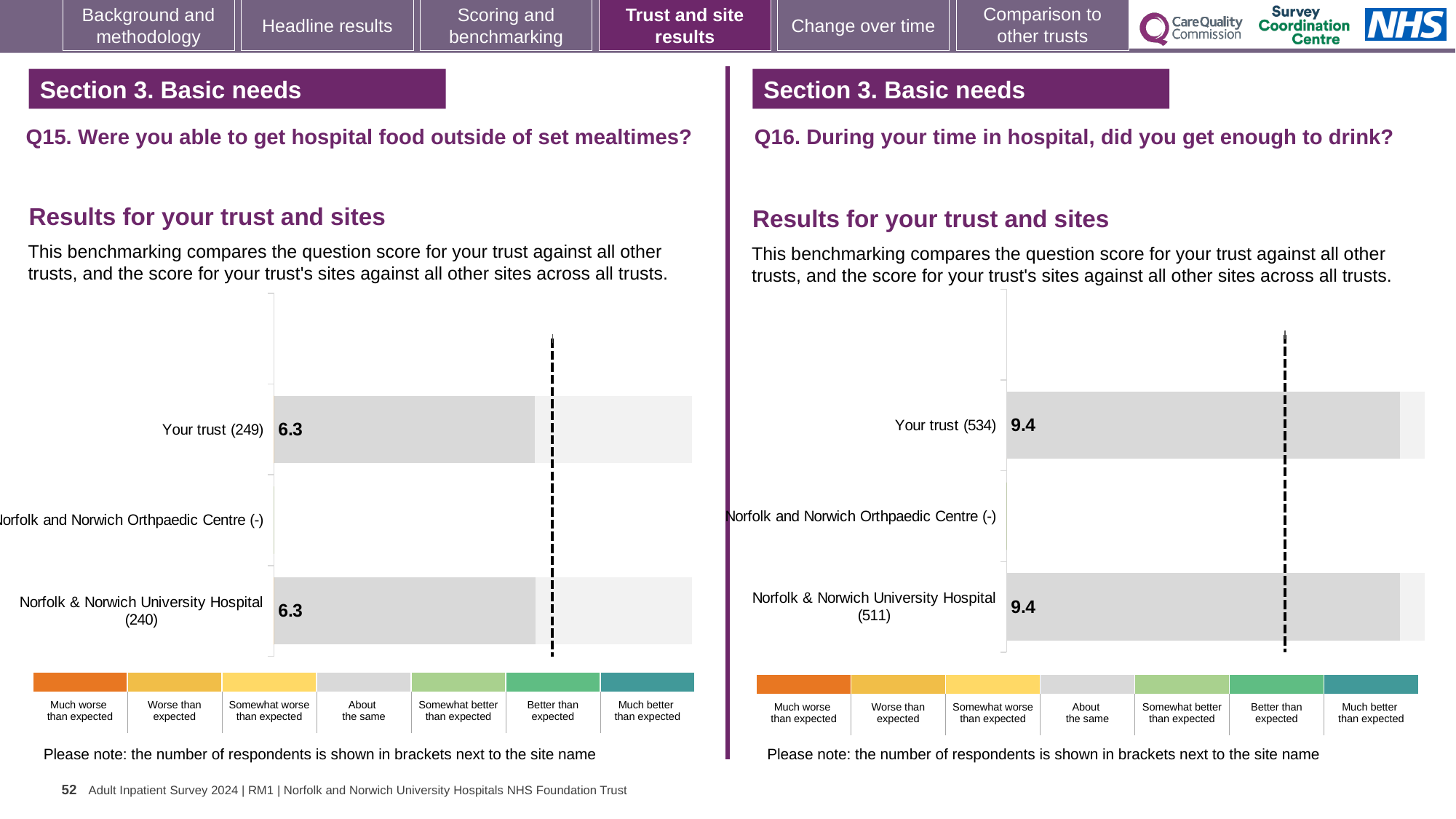
Which is larger: the Your trust score on the Q15 chart (left) or the Your trust score on the Q16 chart (right)? Q16 chart (right) On the Q15 chart (left), what is the score for Your trust? 6.3 On the Q15 chart (left), how many respondents are shown in brackets for Norfolk & Norwich University Hospital? 240 On the Q16 chart (right), what is the score for Your trust? 9.4 What kind of chart is the Q16 chart (right)? Bar chart How many categories are listed on the Q16 chart (right)? 3 How many categories are listed on the Q15 chart (left)? 3 On the Q16 chart (right), how many respondents are shown in brackets for Your trust? 534 What kind of chart is the Q15 chart (left)? Bar chart On the Q16 chart (right), what is the score for Norfolk & Norwich University Hospital? 9.4 On the Q15 chart (left), what is the difference between the Your trust score and the Norfolk & Norwich University Hospital score? 0 On the Q15 chart (left), what is the score for Norfolk & Norwich University Hospital? 6.3